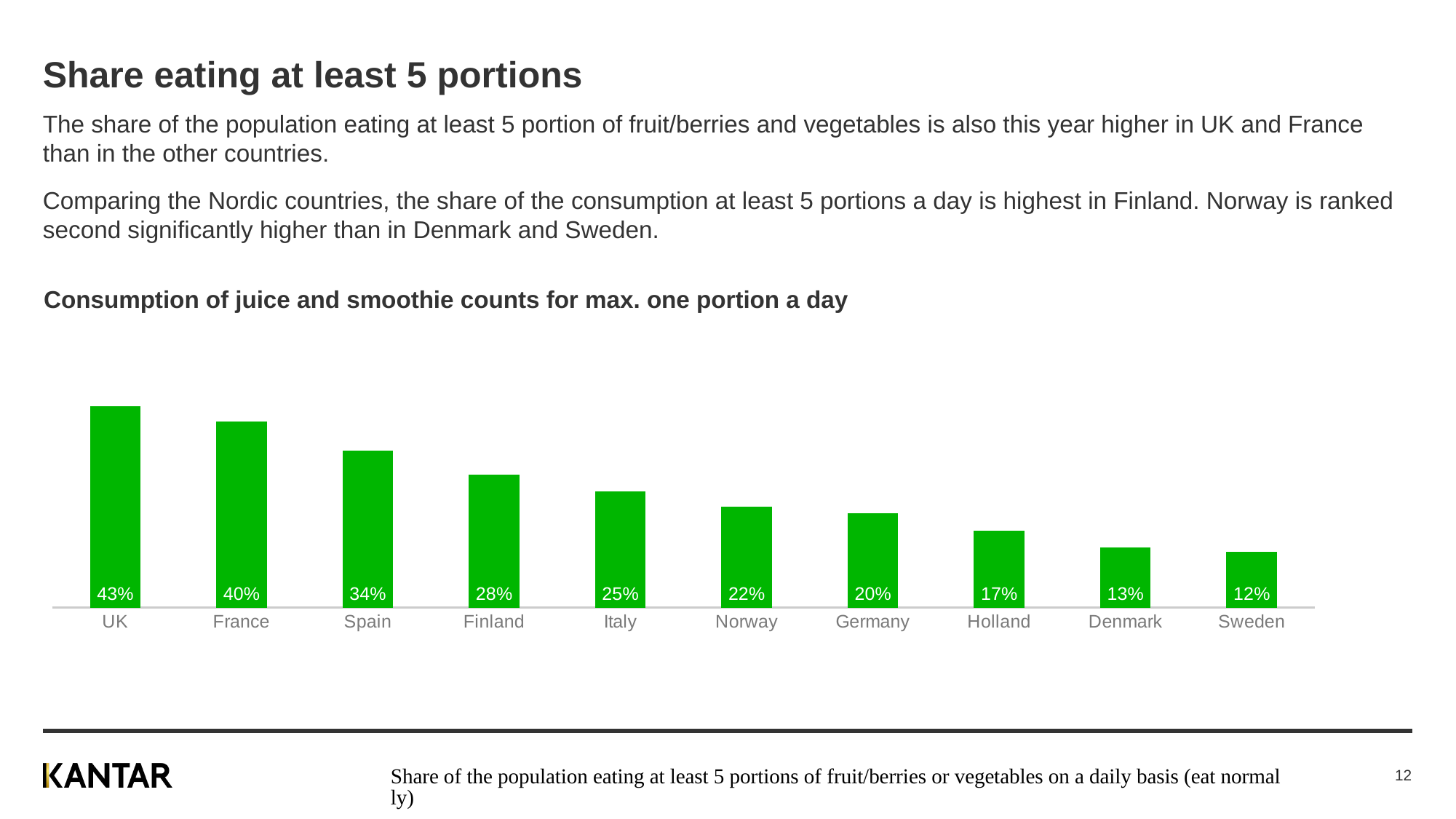
Which country has the highest share? UK What colour are the bars in the chart? Green What is the difference between the values for Norway and Denmark? 9% What is the value for UK? 43% What is the value for Holland? 17% What is the difference between the values for France and Spain? 6% Do the values rise or fall from left to right along the x axis? Fall What kind of chart is shown on the slide? Bar chart Which is larger, the value for Italy or the value for Germany? Italy How many countries are shown in the chart? 10 Which country has the lowest share? Sweden What is the value for Finland? 28%